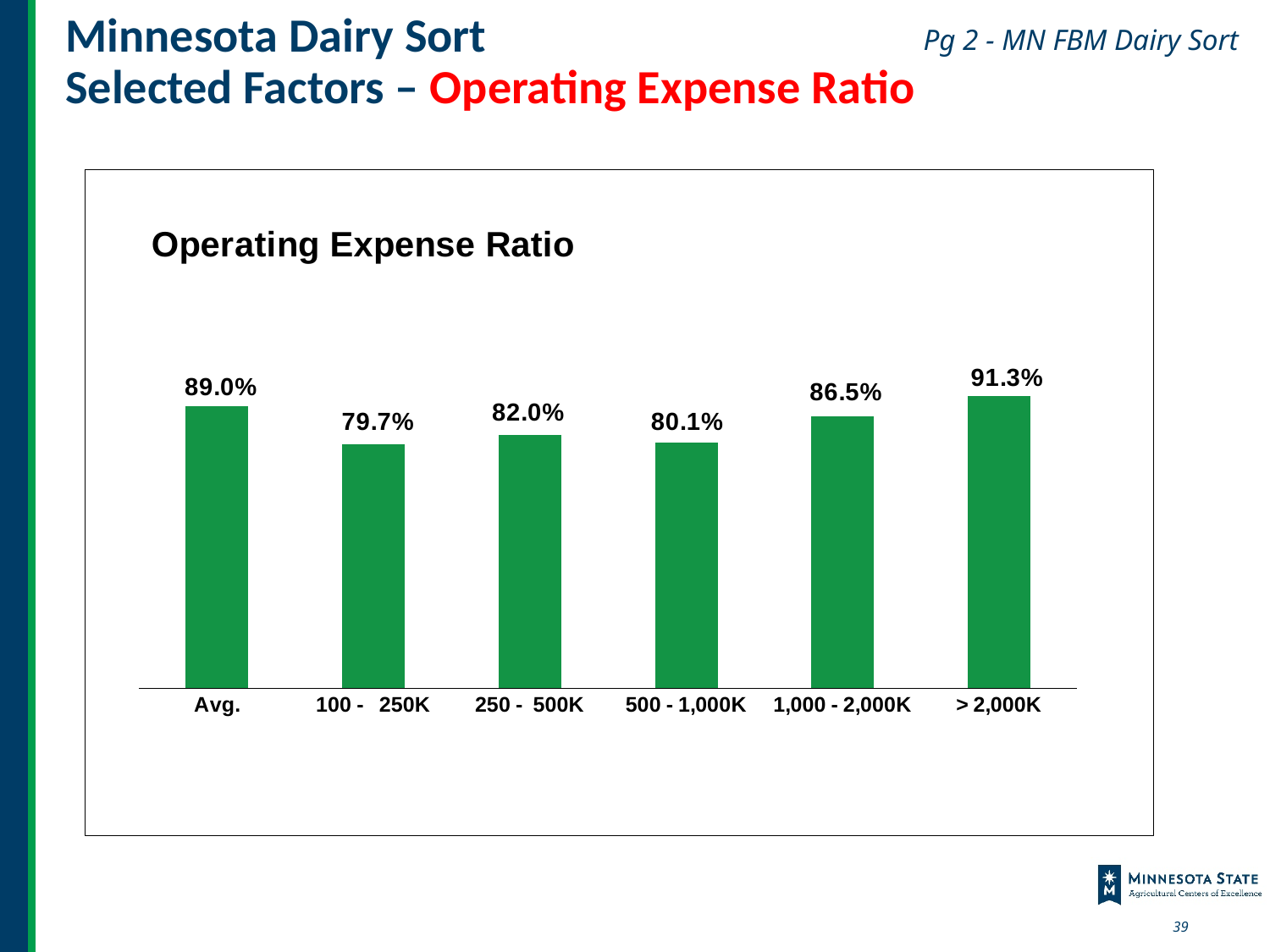
Which has a higher Operating Expense Ratio, 250 - 500K or 500 - 1,000K? 250 - 500K What is the Operating Expense Ratio for the 100 - 250K category? 79.7% What is the difference between the Operating Expense Ratio for Avg. and for 500 - 1,000K? 8.9% Which category has the lowest Operating Expense Ratio? 100 - 250K What is the difference between the Operating Expense Ratio for > 2,000K and for 100 - 250K? 11.6% How many categories are shown on the x axis of the chart? 6 What kind of chart is shown on the slide? Bar chart What is the Operating Expense Ratio for the 1,000 - 2,000K category? 86.5% What is the title of the chart? Operating Expense Ratio Which category has the highest Operating Expense Ratio? > 2,000K What is the Operating Expense Ratio for the > 2,000K category? 91.3% What is the Operating Expense Ratio for the Avg. category? 89.0%